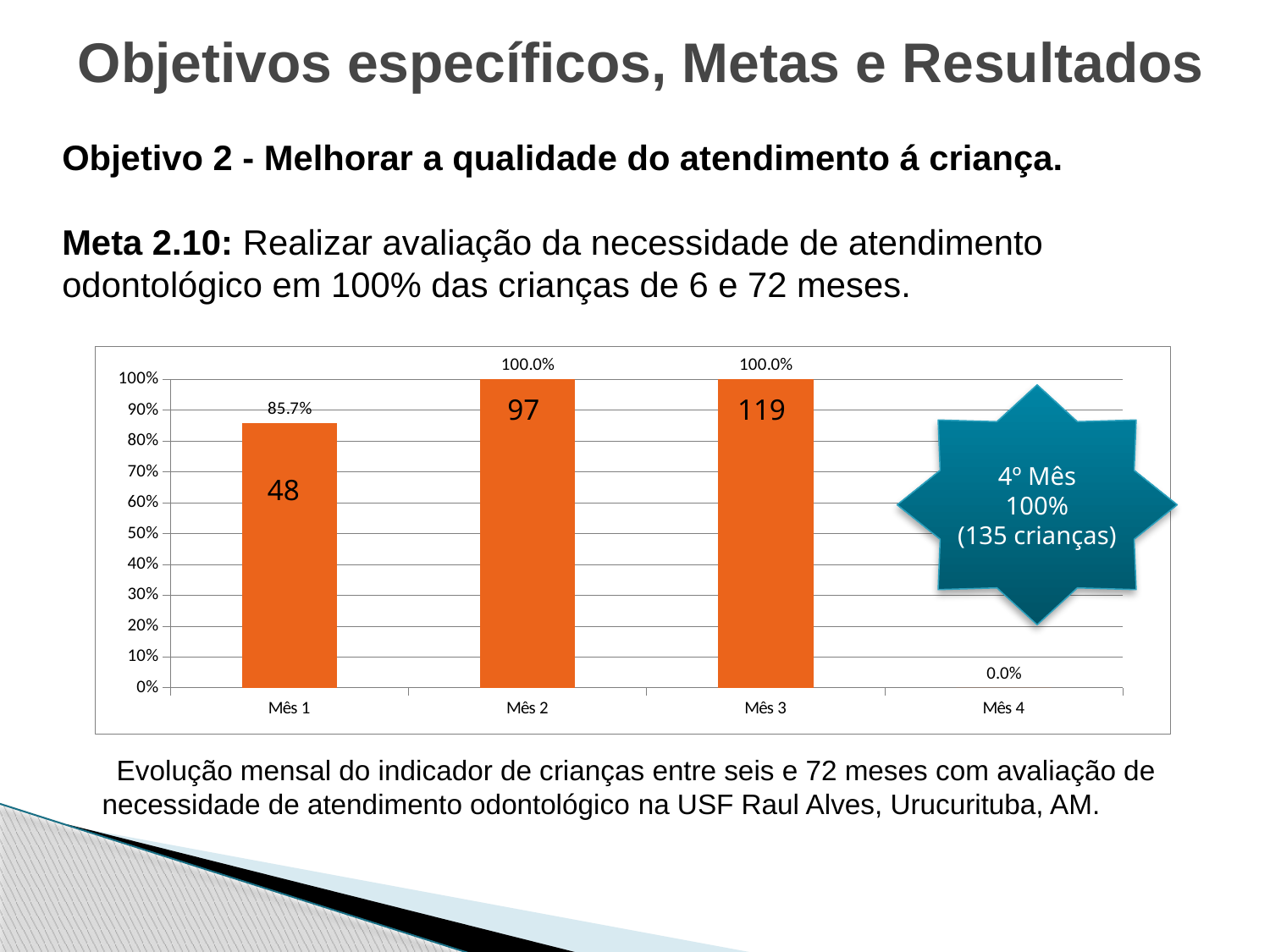
What kind of chart is shown on the slide? bar chart According to the star shape on the chart, how many children does the 4º Mês 100% correspond to? 135 crianças What is the difference in percentage between Mês 2 and Mês 1? 14.3% Which is larger, the percentage for Mês 1 or for Mês 3? Mês 3 What percentage is shown for Mês 4 in the chart? 0.0% What number is printed inside the bar for Mês 3? 119 Which month has the lowest percentage in the chart? Mês 4 How many months are shown on the x axis of the chart? 4 What percentage is shown for Mês 1? 85.7% What number is printed inside the bar for Mês 1? 48 Is the value for Mês 1 greater or less than 80%? greater What percentage is shown for Mês 2? 100.0%